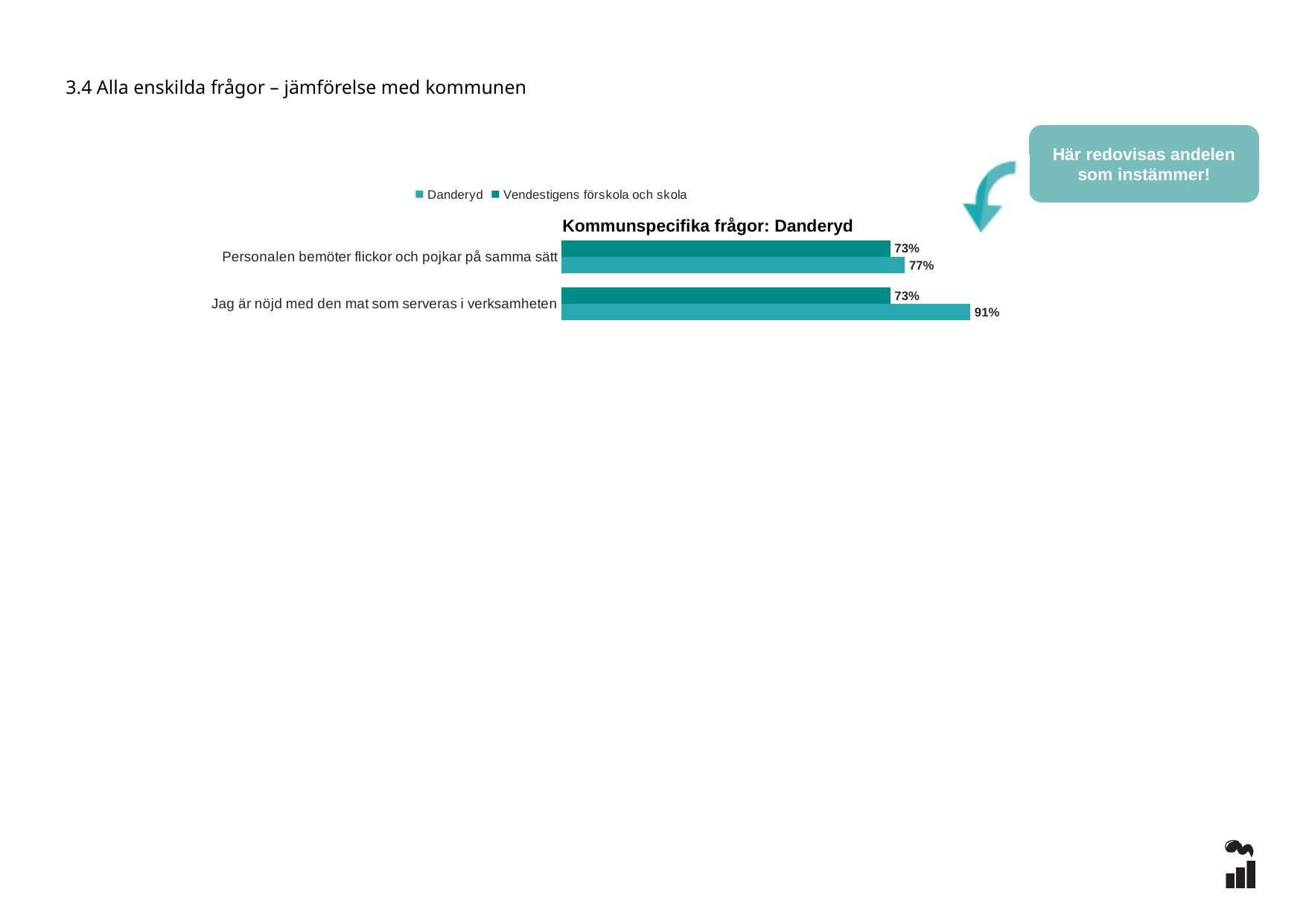
What type of chart is shown on the slide? bar chart What is the difference between Danderyd and Vendestigens förskola och skola for 'Jag är nöjd med den mat som serveras i verksamheten'? 18 percentage points What is the value for Vendestigens förskola och skola for 'Personalen bemöter flickor och pojkar på samma sätt'? 73% Which series has the higher value for 'Jag är nöjd med den mat som serveras i verksamheten'? Danderyd What is the difference between Danderyd and Vendestigens förskola och skola for 'Personalen bemöter flickor och pojkar på samma sätt'? 4 percentage points What is the value for Vendestigens förskola och skola for 'Jag är nöjd med den mat som serveras i verksamheten'? 73% How many series does the legend list? 2 Which bar has the highest value in the chart? Danderyd, Jag är nöjd med den mat som serveras i verksamheten (91%) What is the title of the chart? Kommunspecifika frågor: Danderyd What is the value for Danderyd for 'Jag är nöjd med den mat som serveras i verksamheten'? 91% How many categories (questions) are shown in the chart? 2 What is the value for Danderyd for 'Personalen bemöter flickor och pojkar på samma sätt'? 77%